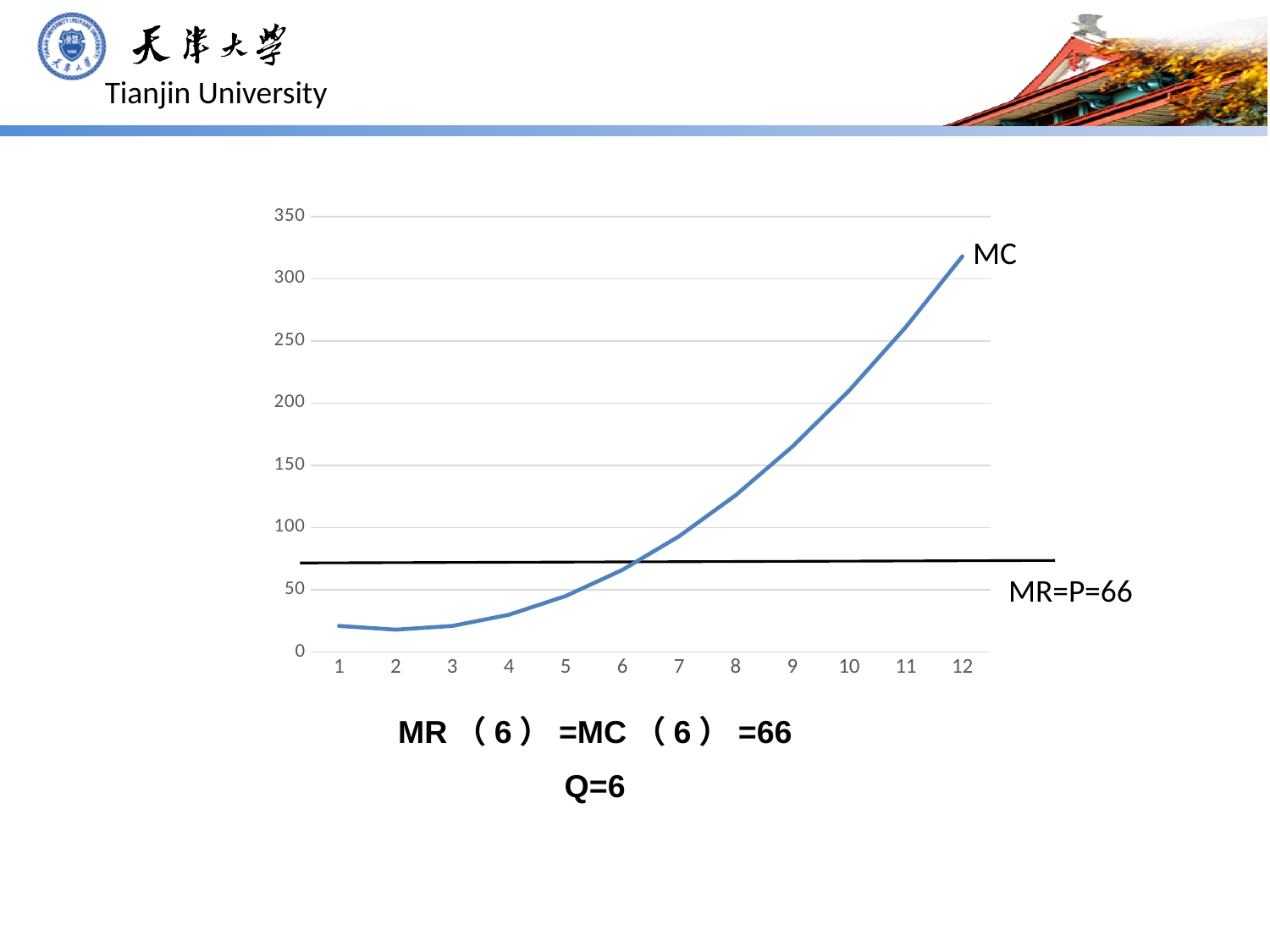
Is the value of MC at Q=12 greater or less than 300? greater At what quantity Q does MR equal MC according to the slide? 6 How many points are labelled on the x axis of the chart? 12 Is the value of MC at Q=11 greater or less than 250? greater At Q=12, which is larger, MC or MR? MC What kind of chart is shown on the slide? line chart What is the value of MC at Q=6 according to the text below the chart? 66 Is the value of MC at Q=8 greater or less than 100? greater Does the MC curve rise or fall as Q increases from 3 to 12? rises What label is attached to the blue curve? MC What is the value of the horizontal MR line according to its label? 66